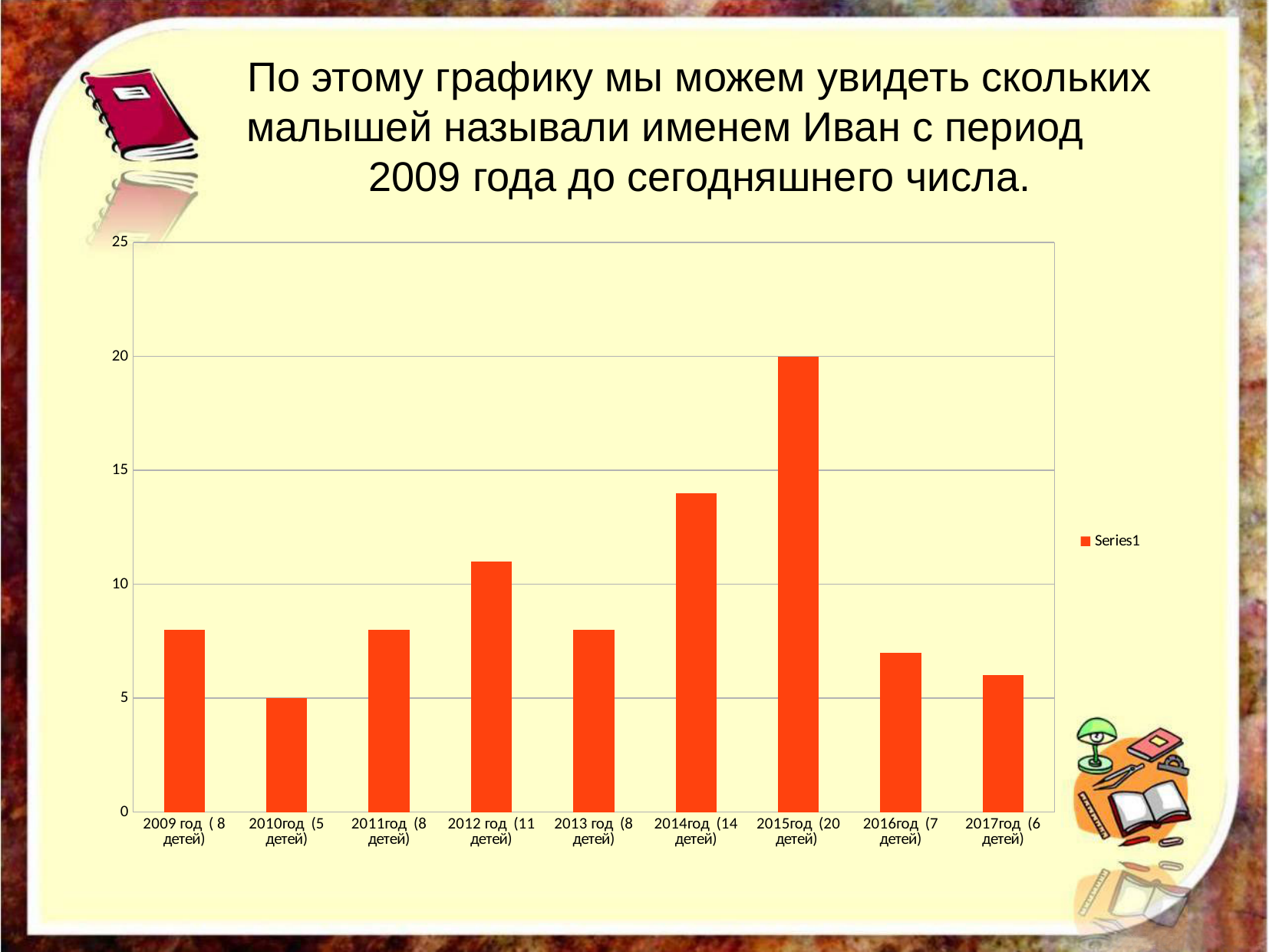
How many children named Ivan are shown for 2014? 14 How many series does the legend list? 1 Which year has the highest number of children named Ivan? 2015 What is the difference between the values for 2015 and 2014? 6 Is the value for 2017 greater or less than 10? less How many children named Ivan are shown for 2015? 20 Which year has a larger value, 2012 or 2016? 2012 What type of chart is shown on the slide? bar chart How many children named Ivan are shown for 2010? 5 Which year has the lowest number of children named Ivan? 2010 What is the name of the series shown in the legend? Series1 How many years (categories) are shown on the x axis? 9